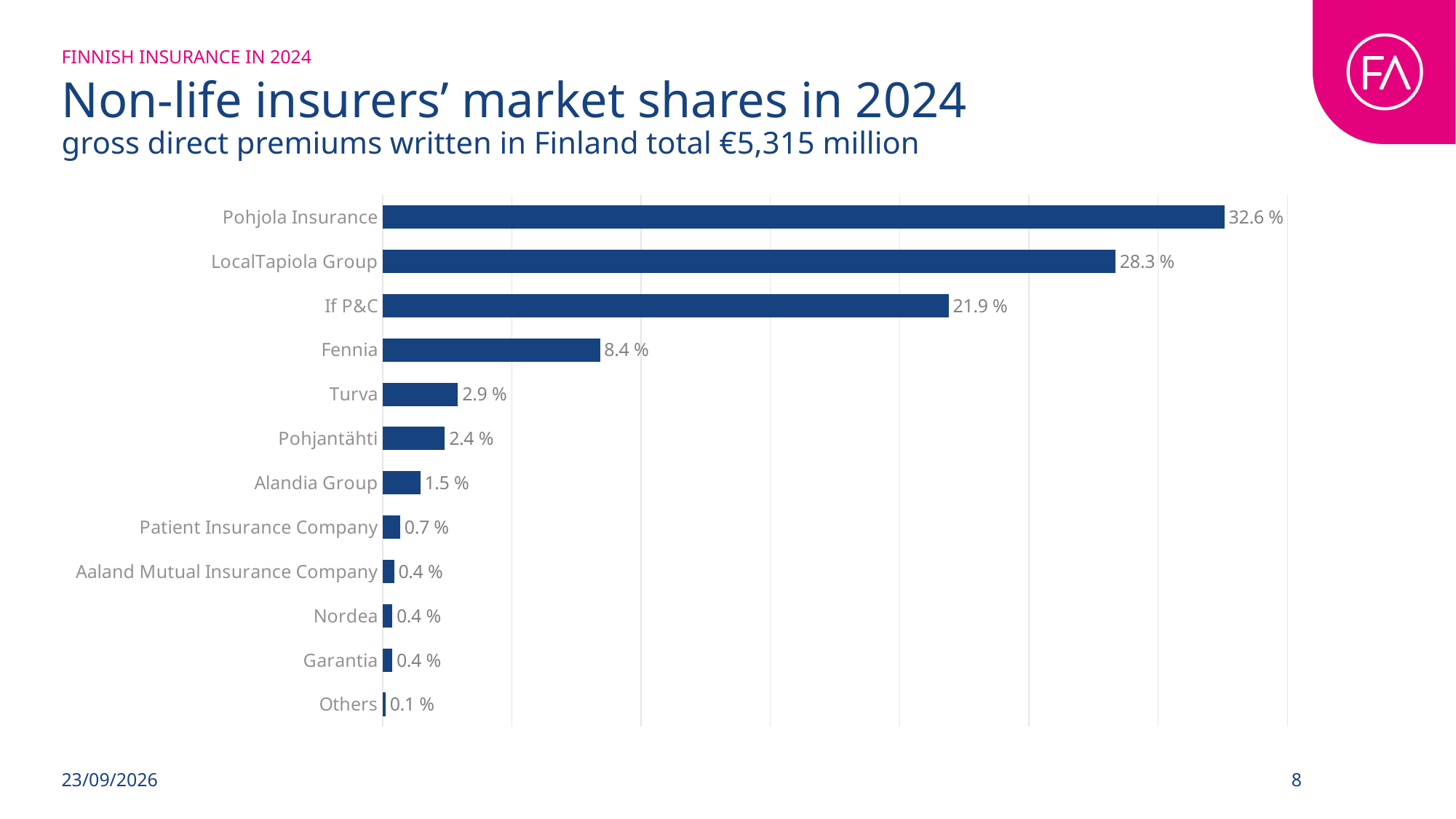
How many categories are shown in the chart? 12 Which category has the lowest market share? Others Which has a larger market share, Turva or Pohjantähti? Turva What is the market share of Alandia Group? 1.5 % What is the title of the chart on the slide? Non-life insurers’ market shares in 2024 What is the market share of If P&C? 21.9 % What is the difference in market share between Pohjola Insurance and LocalTapiola Group? 4.3 % What is the difference in market share between If P&C and Fennia? 13.5 % What is the market share of Pohjola Insurance? 32.6 % Which insurer has the highest market share? Pohjola Insurance What is the market share of Fennia? 8.4 % What kind of chart is shown on the slide? Bar chart